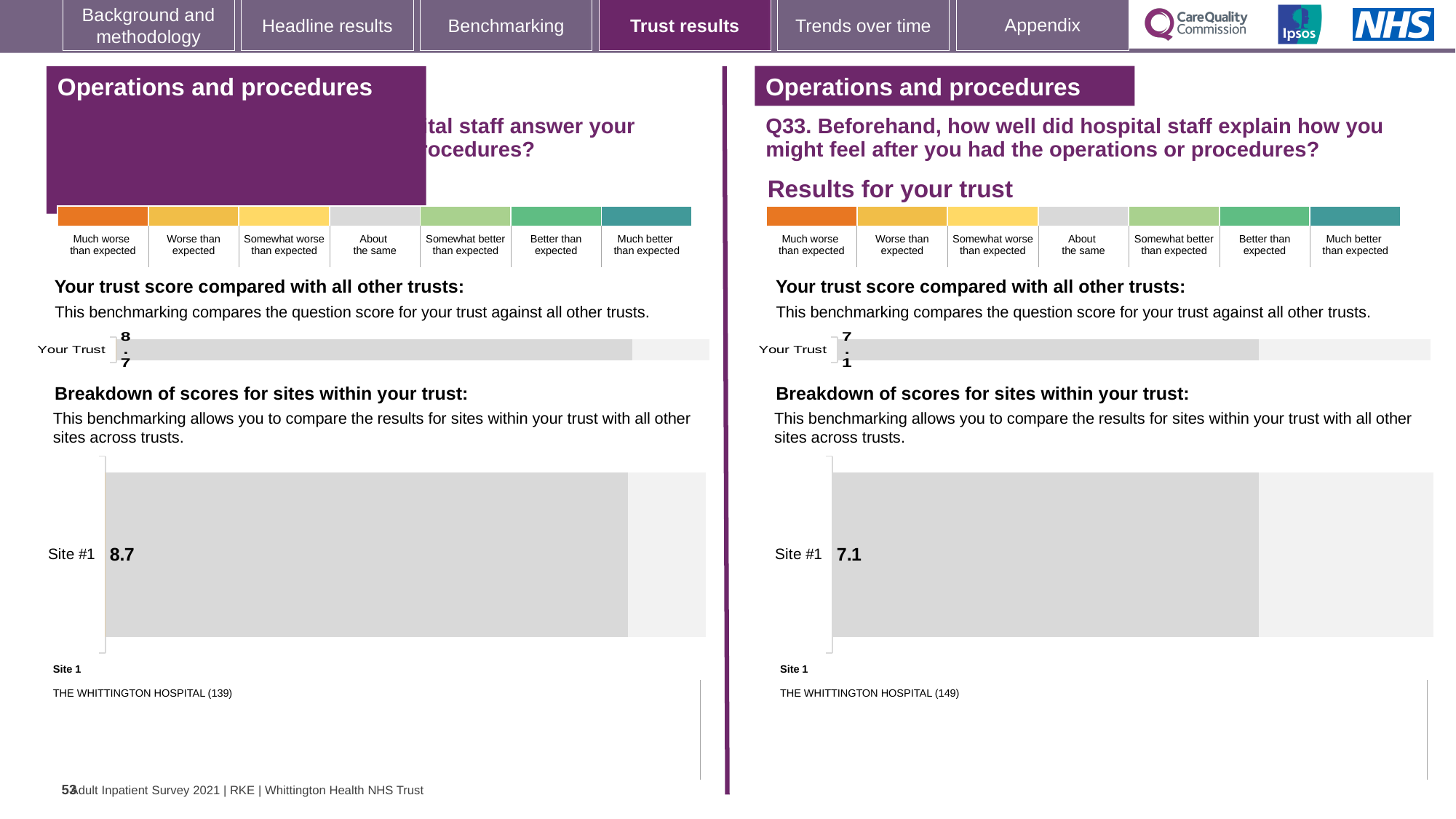
On the right-hand panel (Q33), what is the value shown for Your Trust in the trust score comparison chart? 7.1 Which panel shows the higher Site #1 score, the left-hand panel or the right-hand panel (Q33)? the left-hand panel On the right-hand panel (Q33), which site name is listed as Site 1 below the chart? THE WHITTINGTON HOSPITAL (149) How many sites are plotted in the breakdown of scores for sites within your trust on the left-hand panel? 1 On the right-hand panel (Q33), what is the score shown for Site #1 in the breakdown of scores for sites within your trust? 7.1 On the left-hand panel, what is the score shown for Site #1 in the breakdown of scores for sites within your trust? 8.7 On the left-hand panel, which site name is listed as Site 1 below the chart? THE WHITTINGTON HOSPITAL (139) What kind of chart is used to show the breakdown of scores for sites within your trust on the right-hand panel (Q33)? bar chart On the left-hand panel, what is the value shown for Your Trust in the trust score comparison chart? 8.7 What is the difference between the Site #1 score on the left-hand panel and the Site #1 score on the right-hand panel (Q33)? 1.6 On the right-hand panel (Q33), is the Site #1 score the same as the Your Trust score? yes